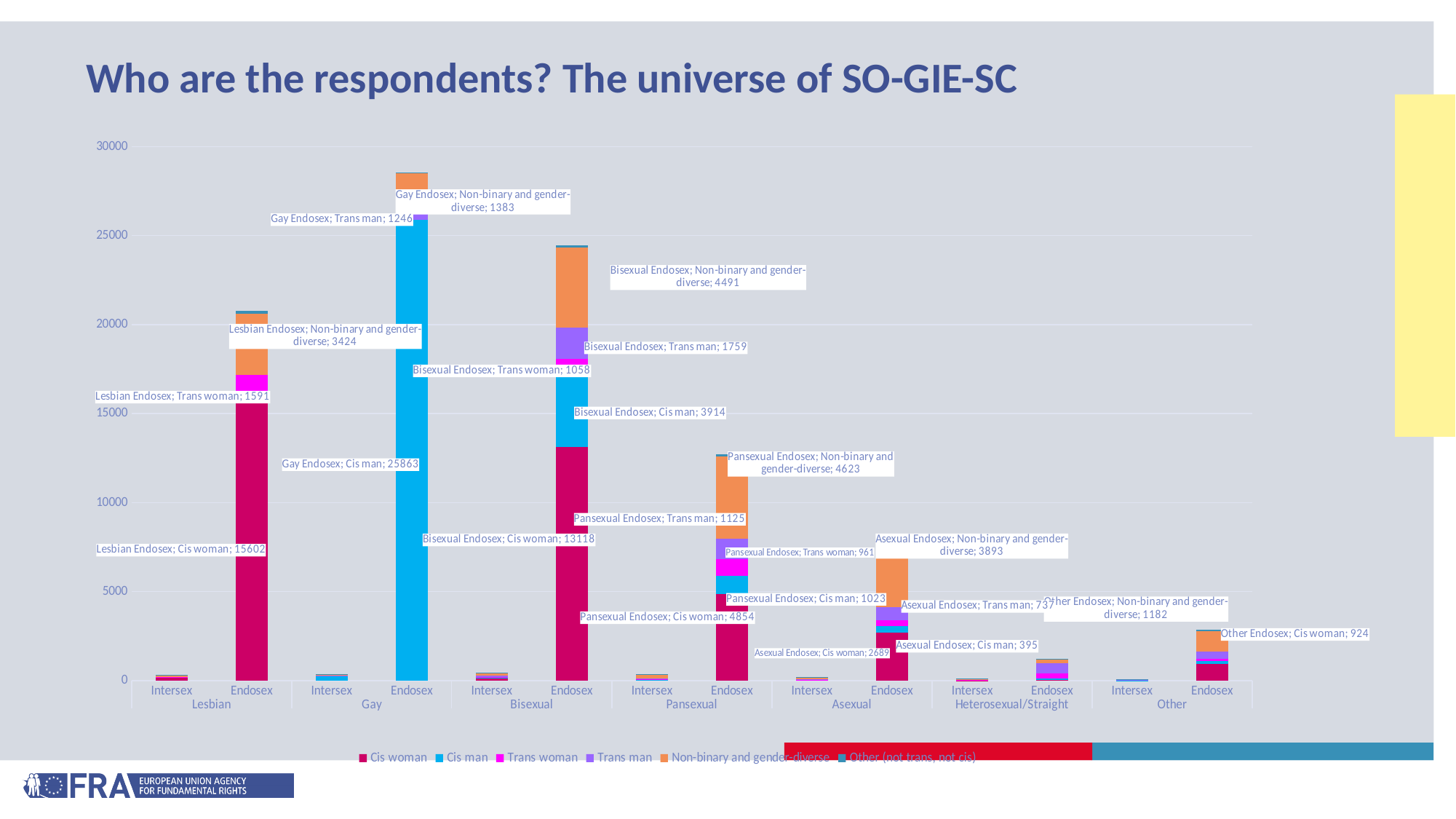
What is the value for Gay Endosex Cis man? 25863 What kind of chart is shown on the slide? Stacked bar chart How many series does the legend list? 6 Which is larger: Pansexual Endosex Non-binary and gender-diverse or Bisexual Endosex Non-binary and gender-diverse? Pansexual Endosex Non-binary and gender-diverse Which sexual orientation group has the tallest Endosex bar? Gay What is the value for Asexual Endosex Cis man? 395 What is the value for Pansexual Endosex Trans woman? 961 What is the value for Bisexual Endosex Non-binary and gender-diverse? 4491 Is the total of the Heterosexual/Straight Endosex bar greater or less than 5000? less Is the total of the Lesbian Endosex bar greater or less than 20000? greater How many sexual orientation groups are shown along the x axis? 7 What is the difference between Lesbian Endosex Cis woman and Bisexual Endosex Cis woman? 2484